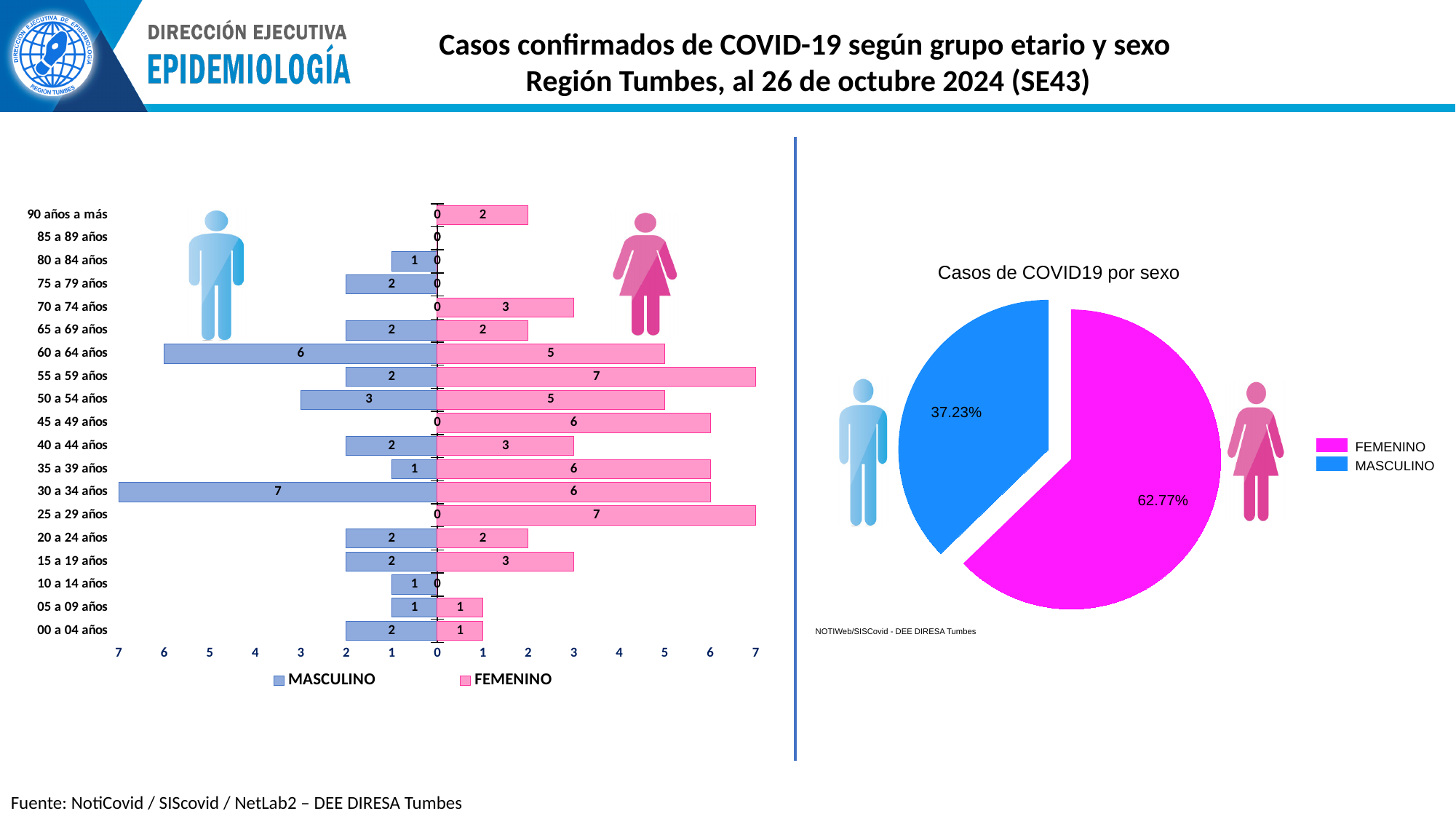
In the pie chart 'Casos de COVID19 por sexo', what share of cases is FEMENINO? 62.77% In the pie chart 'Casos de COVID19 por sexo', which colour represents MASCULINO? Blue In the left bar chart, how many FEMENINO cases are there in the 45 a 49 años group? 6 In the left bar chart, how many series does the legend list? 2 In the left bar chart, which is larger in the 50 a 54 años group, MASCULINO or FEMENINO? FEMENINO What kind of chart is the chart on the left of the slide? Bar chart In the left bar chart, how many age groups are shown? 19 In the left bar chart, how many MASCULINO cases are there in the 60 a 64 años group? 6 In the left bar chart, how many FEMENINO cases are there in the 55 a 59 años group? 7 In the left bar chart, which age group has the highest number of MASCULINO cases? 30 a 34 años In the pie chart 'Casos de COVID19 por sexo', what share of cases is MASCULINO? 37.23% In the left bar chart, what is the difference between FEMENINO and MASCULINO cases in the 35 a 39 años group? 5